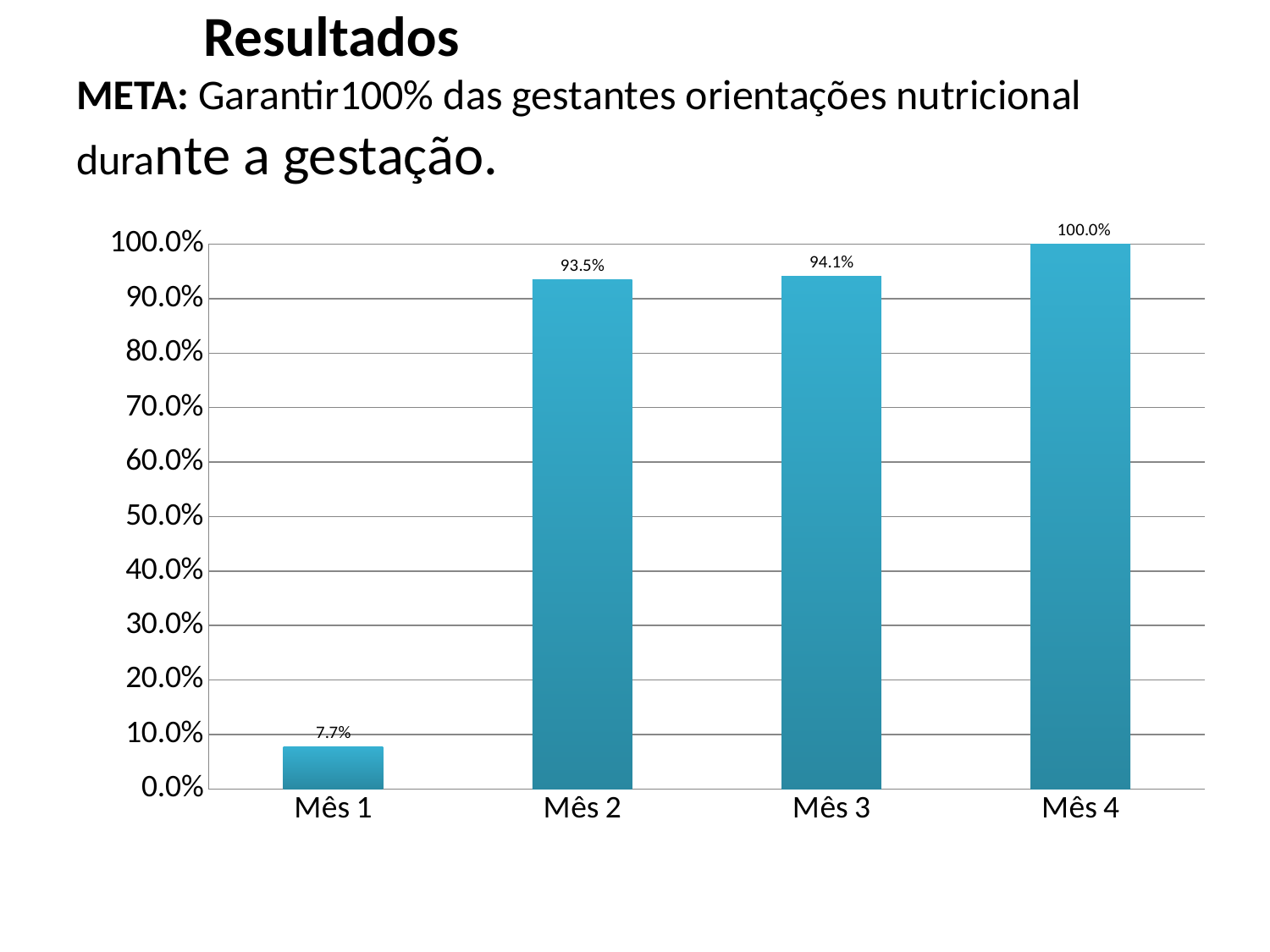
What is the value for Mês 3? 94.1% What is the value for Mês 2? 93.5% Which month has the highest value? Mês 4 How many months are shown on the x axis? 4 Which month has the lowest value? Mês 1 What kind of chart is shown on the slide? bar chart What is the difference between the values for Mês 4 and Mês 1? 92.3% What is the value for Mês 4? 100.0% What is the difference between the values for Mês 3 and Mês 2? 0.6% What is the value for Mês 1? 7.7% Which is larger, the value for Mês 2 or the value for Mês 1? Mês 2 Is the value for Mês 1 greater or less than 10.0%? less